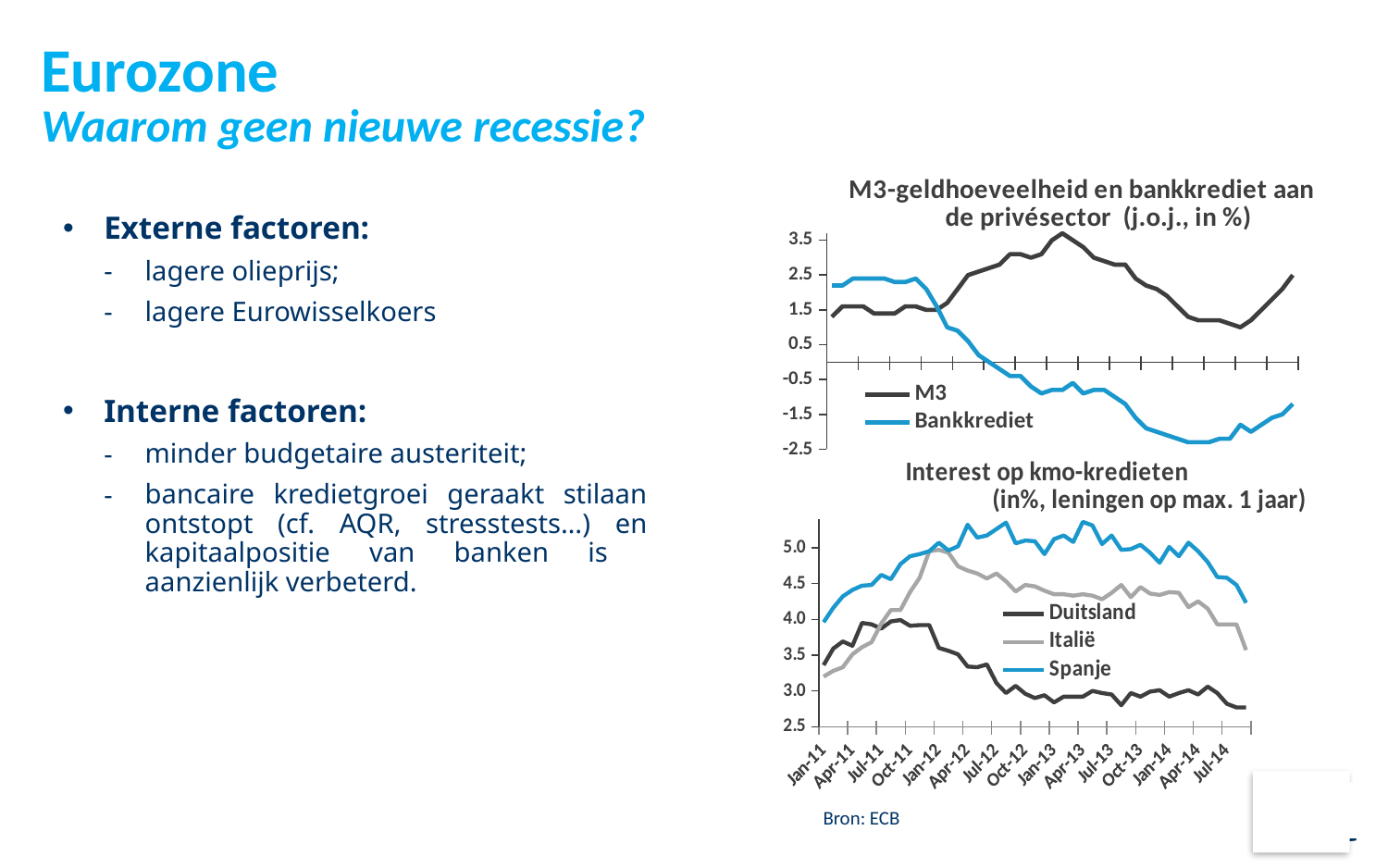
In the top chart (M3-geldhoeveelheid en bankkrediet), does the Bankkrediet series overall rise or fall from Jan-11 to Jul-14? fall In the top chart (M3-geldhoeveelheid en bankkrediet), which series is higher at the end of the period, M3 or Bankkrediet? M3 What kind of chart is the top chart titled 'M3-geldhoeveelheid en bankkrediet aan de privésector'? line chart How many series does the legend of the top chart (M3-geldhoeveelheid en bankkrediet) list? 2 In the top chart (M3-geldhoeveelheid en bankkrediet), which two series are shown in the legend? M3 and Bankkrediet In the bottom chart (Interest op kmo-kredieten), which country has the lowest interest rate at the end of the period? Duitsland In the bottom chart (Interest op kmo-kredieten), is the peak value for Spanje greater or less than 5.0? greater In the bottom chart (Interest op kmo-kredieten), which country has the highest interest rate at the end of the period? Spanje In the bottom chart (Interest op kmo-kredieten), does the Duitsland series overall rise or fall from Jan-11 to Jul-14? fall How many series does the legend of the bottom chart (Interest op kmo-kredieten) list? 3 In the top chart (M3-geldhoeveelheid en bankkrediet), is the value of M3 at the end of the series greater or less than 1.5? greater In the top chart (M3-geldhoeveelheid en bankkrediet), is the value of Bankkrediet at the end of the series greater or less than 0? less